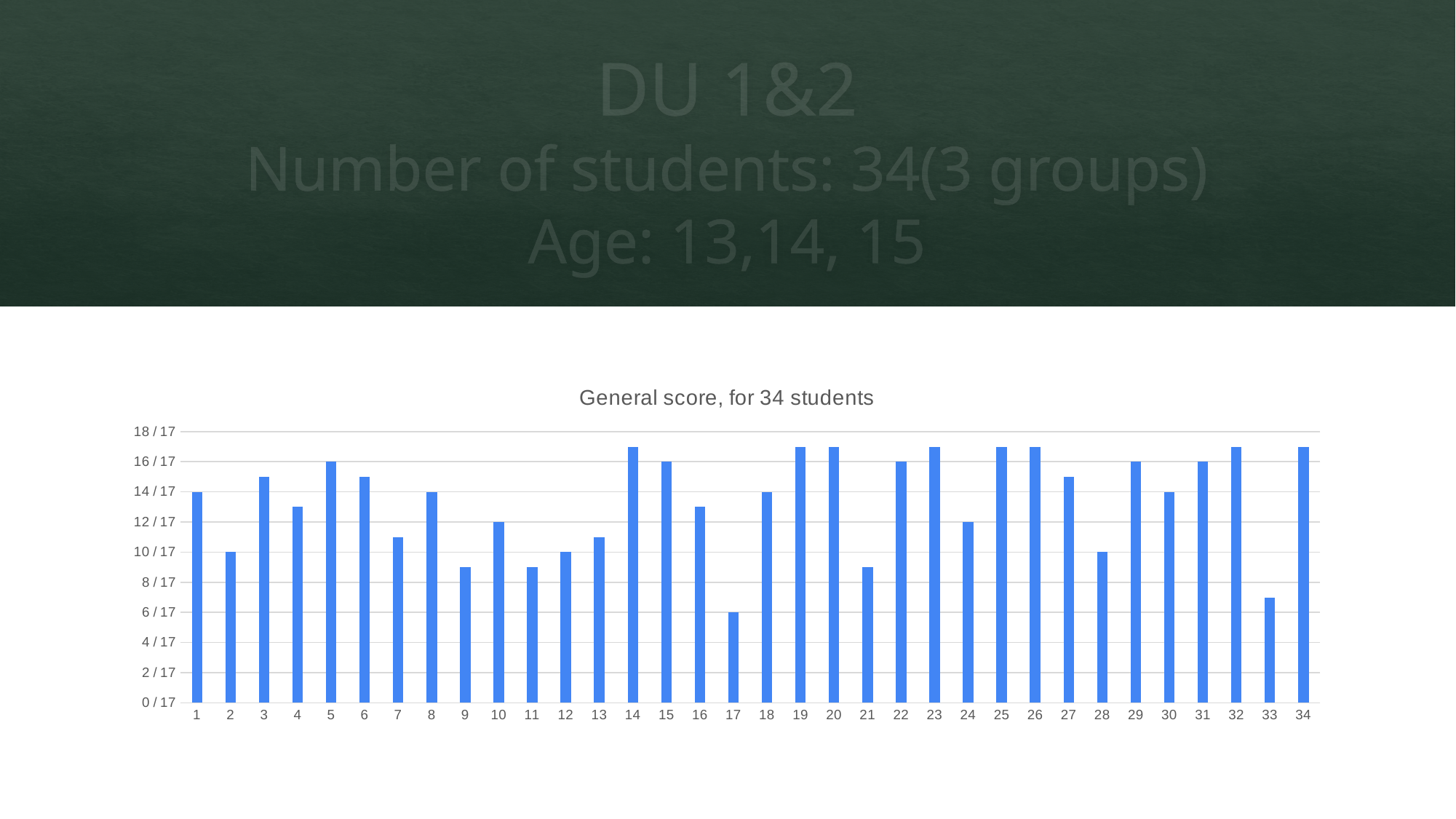
Which student has the lowest general score? 17 How many students (categories) are plotted on the x axis? 34 What is the general score for student 30? 14 / 17 Is the score for student 14 greater or less than 16 / 17? greater What is the general score for student 24? 12 / 17 What is the title of the chart? General score, for 34 students What type of chart is shown on the slide? bar chart What is the general score for student 5? 16 / 17 What is the general score for student 17? 6 / 17 Is the score for student 33 greater or less than 8 / 17? less What is the general score for student 2? 10 / 17 Which student has the higher score, student 3 or student 4? student 3